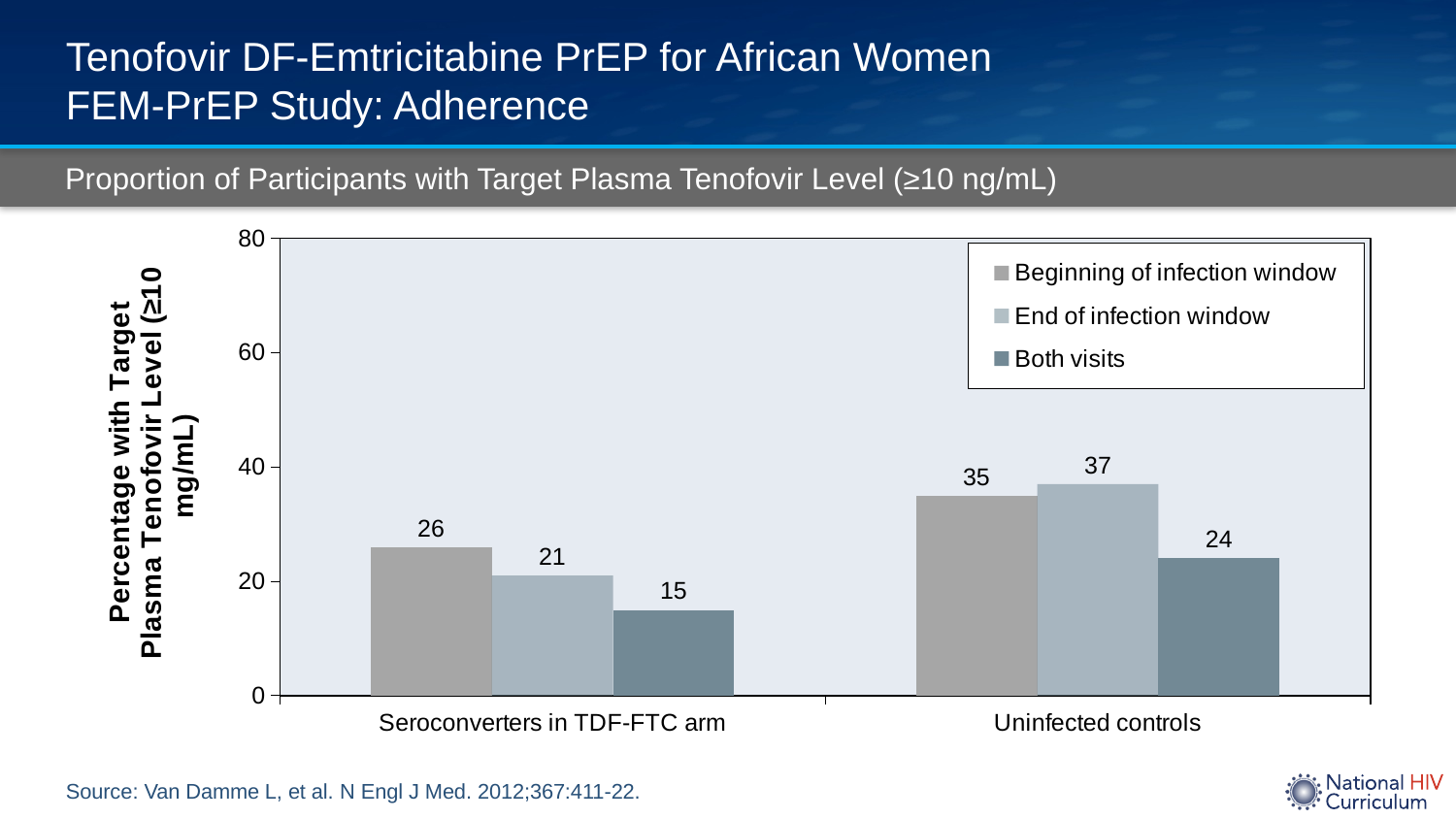
Which series has the lowest value in the Seroconverters in TDF-FTC arm group? Both visits How many categories are shown on the x axis? 2 What is the value for 'Both visits' in the Uninfected controls group? 24 Which series has the highest value in the Uninfected controls group? End of infection window Which is larger: the 'Both visits' value for Seroconverters in TDF-FTC arm or for Uninfected controls? Uninfected controls How many series does the legend list? 3 Is the 'End of infection window' value for Seroconverters in TDF-FTC arm greater or less than 40? less What is the value for 'End of infection window' in the Uninfected controls group? 37 What kind of chart is shown on the slide? Bar chart What is the value for 'Beginning of infection window' in the Seroconverters in TDF-FTC arm group? 26 What is the difference between the 'Beginning of infection window' values for Uninfected controls and Seroconverters in TDF-FTC arm? 9 What is the label of the y axis? Percentage with Target Plasma Tenofovir Level (≥10 mg/mL)